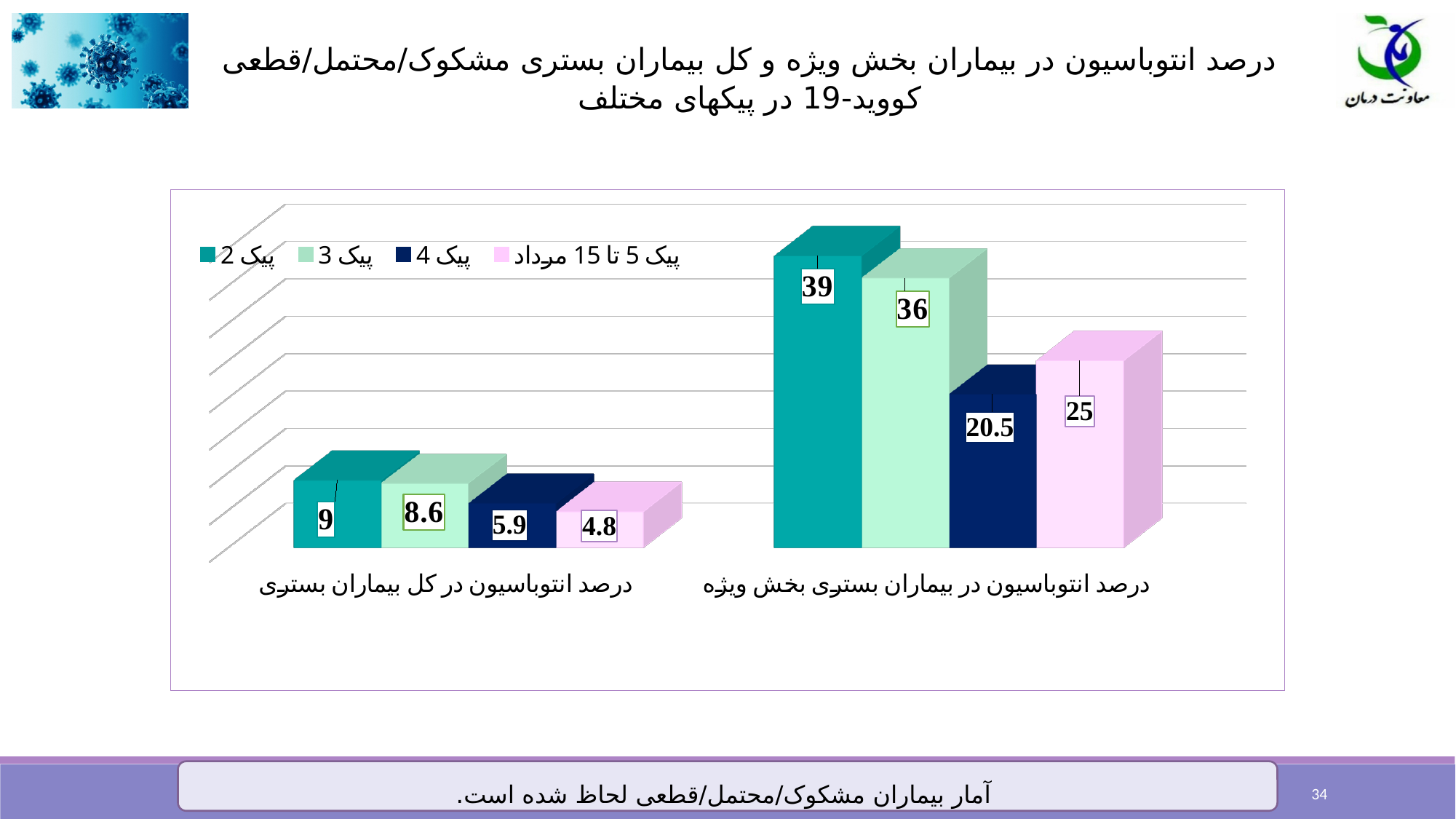
What is the value for پیک 5 تا 15 مرداد in the category درصد انتوباسیون در کل بیماران بستری? 4.8 What is the difference between the پیک 2 and پیک 4 values in the category درصد انتوباسیون در کل بیماران بستری? 3.1 How many series does the legend list? 4 Which series has the highest value in the category درصد انتوباسیون در بیماران بستری بخش ویژه? پیک 2 What kind of chart is shown on the slide? Bar chart What is the value for پیک 3 in the category درصد انتوباسیون در کل بیماران بستری? 8.6 In the category درصد انتوباسیون در بیماران بستری بخش ویژه, which is larger: پیک 4 or پیک 5 تا 15 مرداد? پیک 5 تا 15 مرداد What is the value for پیک 4 in the category درصد انتوباسیون در بیماران بستری بخش ویژه? 20.5 How many categories are shown on the x axis? 2 What is the value for پیک 2 in the category درصد انتوباسیون در بیماران بستری بخش ویژه? 39 What is the difference between the پیک 2 and پیک 3 values in the category درصد انتوباسیون در بیماران بستری بخش ویژه? 3 Which series has the lowest value in the category درصد انتوباسیون در کل بیماران بستری? پیک 5 تا 15 مرداد